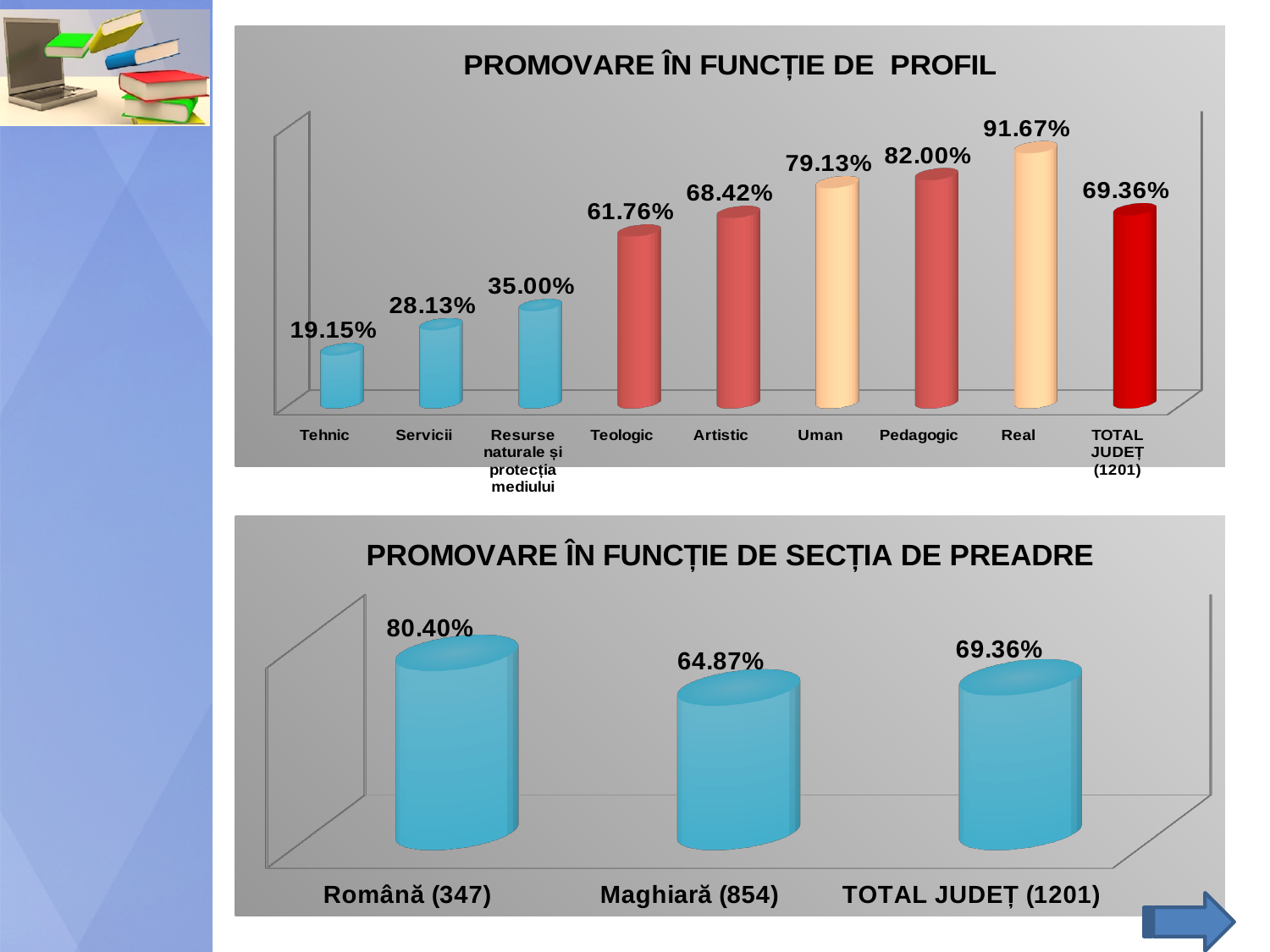
In the chart titled 'PROMOVARE ÎN FUNCȚIE DE PROFIL', which category has the highest value? Real In the chart titled 'PROMOVARE ÎN FUNCȚIE DE SECȚIA DE PREADRE', which category has the highest value? Română (347) In the chart titled 'PROMOVARE ÎN FUNCȚIE DE PROFIL', what is the difference between the values for Real and Tehnic? 72.52% In the chart titled 'PROMOVARE ÎN FUNCȚIE DE PROFIL', which category has the lowest value? Tehnic In the chart titled 'PROMOVARE ÎN FUNCȚIE DE SECȚIA DE PREADRE', what is the value for Maghiară (854)? 64.87% In the chart titled 'PROMOVARE ÎN FUNCȚIE DE PROFIL', what is the value for Tehnic? 19.15% In the chart titled 'PROMOVARE ÎN FUNCȚIE DE PROFIL', which is larger, the value for Teologic or the value for Artistic? Artistic In the chart titled 'PROMOVARE ÎN FUNCȚIE DE PROFIL', how many categories are shown? 9 In the chart titled 'PROMOVARE ÎN FUNCȚIE DE PROFIL', what is the value for Pedagogic? 82.00% In the chart titled 'PROMOVARE ÎN FUNCȚIE DE SECȚIA DE PREADRE', what is the difference between the values for Română (347) and Maghiară (854)? 15.53% In the chart titled 'PROMOVARE ÎN FUNCȚIE DE PROFIL', what is the value for Resurse naturale și protecția mediului? 35.00% What kind of chart is the chart titled 'PROMOVARE ÎN FUNCȚIE DE SECȚIA DE PREADRE'? Bar chart